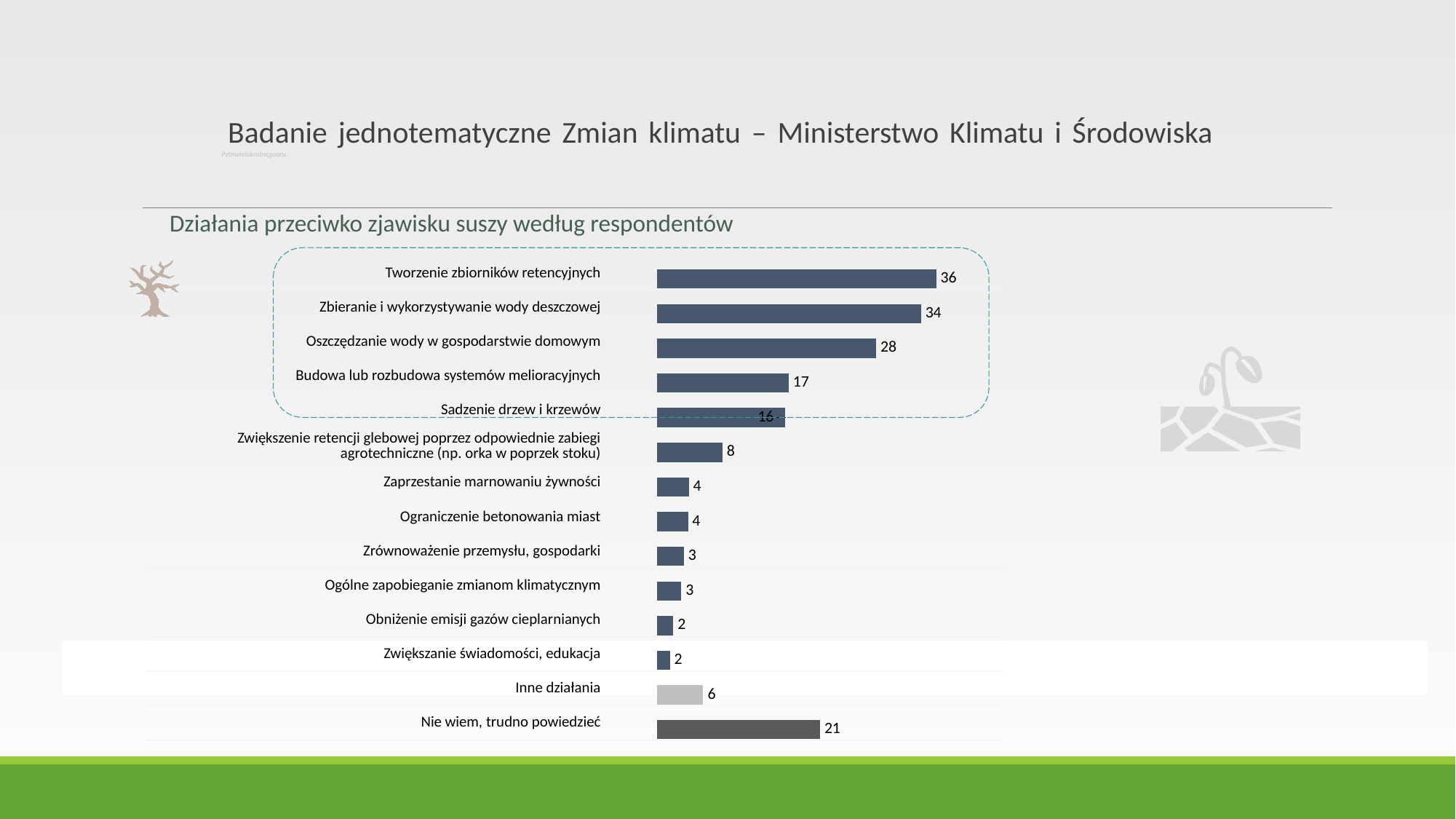
What is the difference between the values for "Tworzenie zbiorników retencyjnych" and "Zbieranie i wykorzystywanie wody deszczowej"? 2 What is the difference between the values for "Budowa lub rozbudowa systemów melioracyjnych" and "Zwiększenie retencji glebowej poprzez odpowiednie zabiegi agrotechniczne (np. orka w poprzek stoku)"? 9 What kind of chart is shown on the slide? Bar chart How many categories are shown in the chart? 14 What is the title of the chart? Działania przeciwko zjawisku suszy według respondentów Which is larger: the value for "Inne działania" or the value for "Zaprzestanie marnowaniu żywności"? Inne działania Which category has the highest value in the chart? Tworzenie zbiorników retencyjnych What value is shown for "Oszczędzanie wody w gospodarstwie domowym"? 28 What value is shown for "Nie wiem, trudno powiedzieć"? 21 Which is larger: the value for "Nie wiem, trudno powiedzieć" or the value for "Budowa lub rozbudowa systemów melioracyjnych"? Nie wiem, trudno powiedzieć What value is shown for "Tworzenie zbiorników retencyjnych"? 36 What value is shown for "Inne działania"? 6